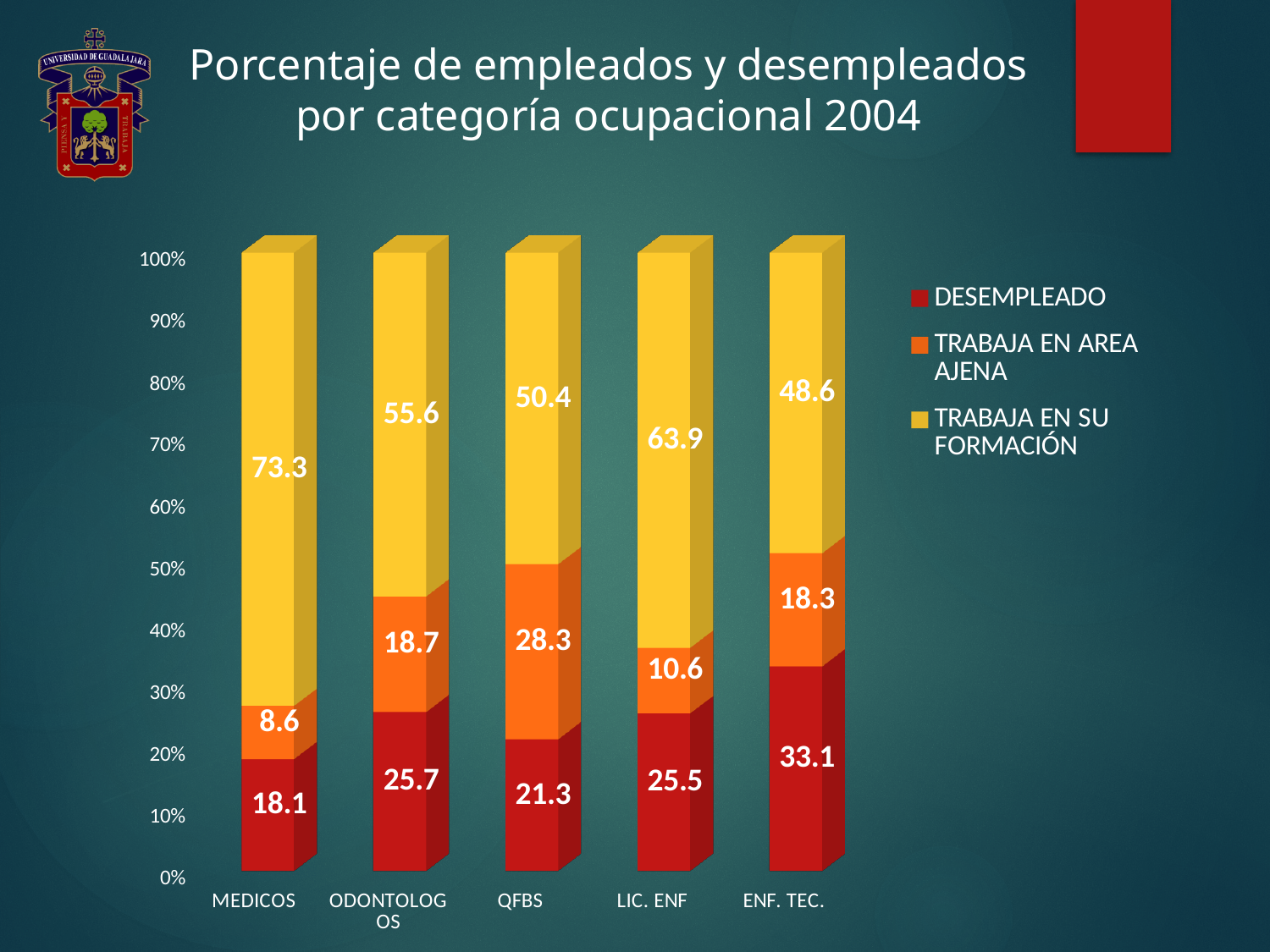
How many series does the legend list? 3 Which is larger, the TRABAJA EN AREA AJENA value for ODONTOLOGOS or for LIC. ENF? ODONTOLOGOS What type of chart is shown on the slide? Stacked bar chart What is the TRABAJA EN SU FORMACIÓN value for LIC. ENF? 63.9 What is the TRABAJA EN AREA AJENA value for QFBS? 28.3 What is the total of the stacked bar for QFBS? 100 Which series is shown in yellow in the legend? TRABAJA EN SU FORMACIÓN What is the DESEMPLEADO value for MEDICOS? 18.1 What is the difference between the TRABAJA EN SU FORMACIÓN values for MEDICOS and ENF. TEC.? 24.7 Which category has the highest DESEMPLEADO value? ENF. TEC. How many occupational categories are shown on the x axis? 5 Which category has the lowest TRABAJA EN SU FORMACIÓN value? ENF. TEC.